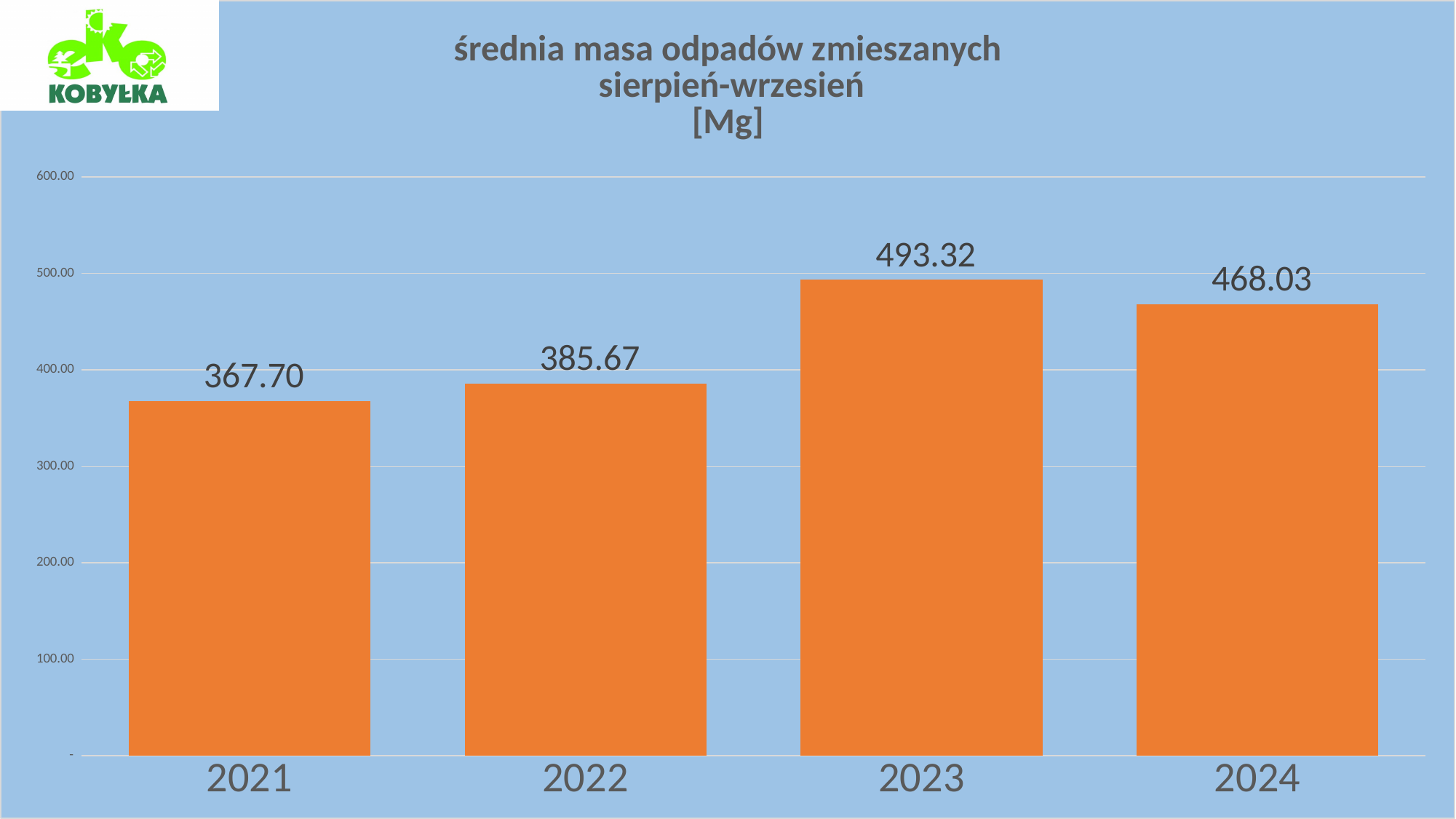
Which year has the highest value? 2023 Which is larger, the value for 2022 or the value for 2024? 2024 What kind of chart is shown on the slide? bar chart What unit is given in the chart title? Mg How many years are shown on the x axis? 4 What is the value for 2023? 493.32 Which year has the lowest value? 2021 What is the value for 2024? 468.03 What is the value for 2021? 367.70 Is the value for 2023 greater or less than 400.00? greater What is the difference between the values for 2022 and 2021? 17.97 What is the difference between the values for 2023 and 2024? 25.29